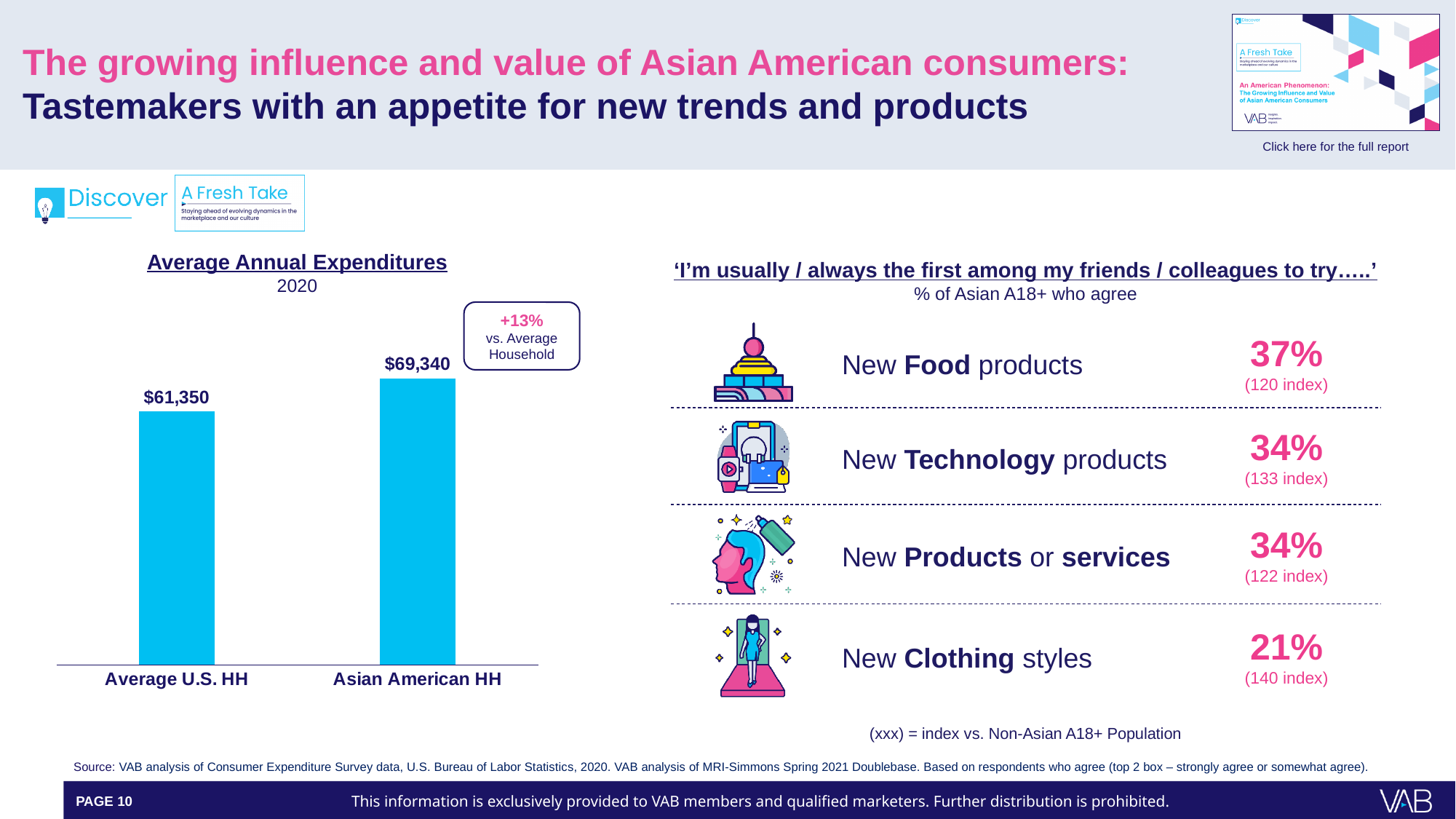
In the Average Annual Expenditures chart, what is the value for Asian American HH? $69,340 In the Average Annual Expenditures chart, which category has the highest value? Asian American HH According to the callout on the Average Annual Expenditures chart, by what percentage do Asian American HH expenditures exceed the average household? +13% In the Average Annual Expenditures chart, which is larger: Average U.S. HH or Asian American HH? Asian American HH What type of chart is the Average Annual Expenditures chart? Bar chart In the Average Annual Expenditures chart, which category has the lowest value? Average U.S. HH What is the title of the bar chart on the left of the slide? Average Annual Expenditures How many bars are shown in the Average Annual Expenditures chart? 2 What year does the Average Annual Expenditures chart cover? 2020 In the Average Annual Expenditures chart, what is the value for Average U.S. HH? $61,350 In the Average Annual Expenditures chart, what is the difference between the Asian American HH value and the Average U.S. HH value? $7,990